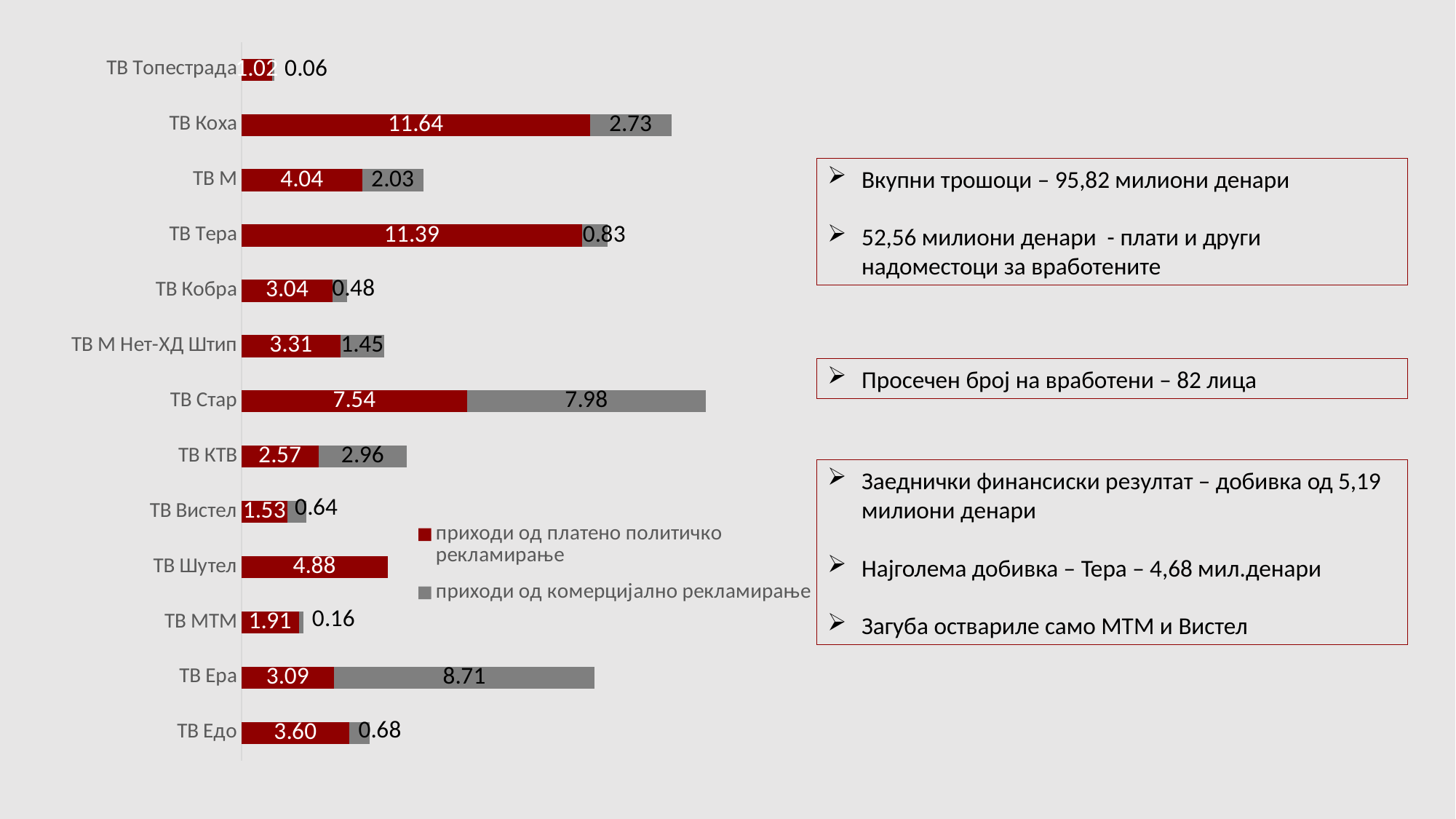
What is the total of the stacked bar for ТВ Ера? 11.80 What is the total of the stacked bar for ТВ Стар? 15.52 What is the value of приходи од комерцијално рекламирање for ТВ Стар? 7.98 How many series does the legend list? 2 Which TV station has the highest value for приходи од комерцијално рекламирање? ТВ Ера What kind of chart is shown on the slide? Stacked bar chart Which TV station has the lowest value for приходи од платено политичко рекламирање? ТВ Топестрада For ТВ Стар, which is larger: приходи од платено политичко рекламирање or приходи од комерцијално рекламирање? приходи од комерцијално рекламирање What is the difference between приходи од платено политичко рекламирање and приходи од комерцијално рекламирање for ТВ Коха? 8.91 What is the value of приходи од комерцијално рекламирање for ТВ Ера? 8.71 What is the value of приходи од платено политичко рекламирање for ТВ Коха? 11.64 How many TV stations are shown in the chart? 13